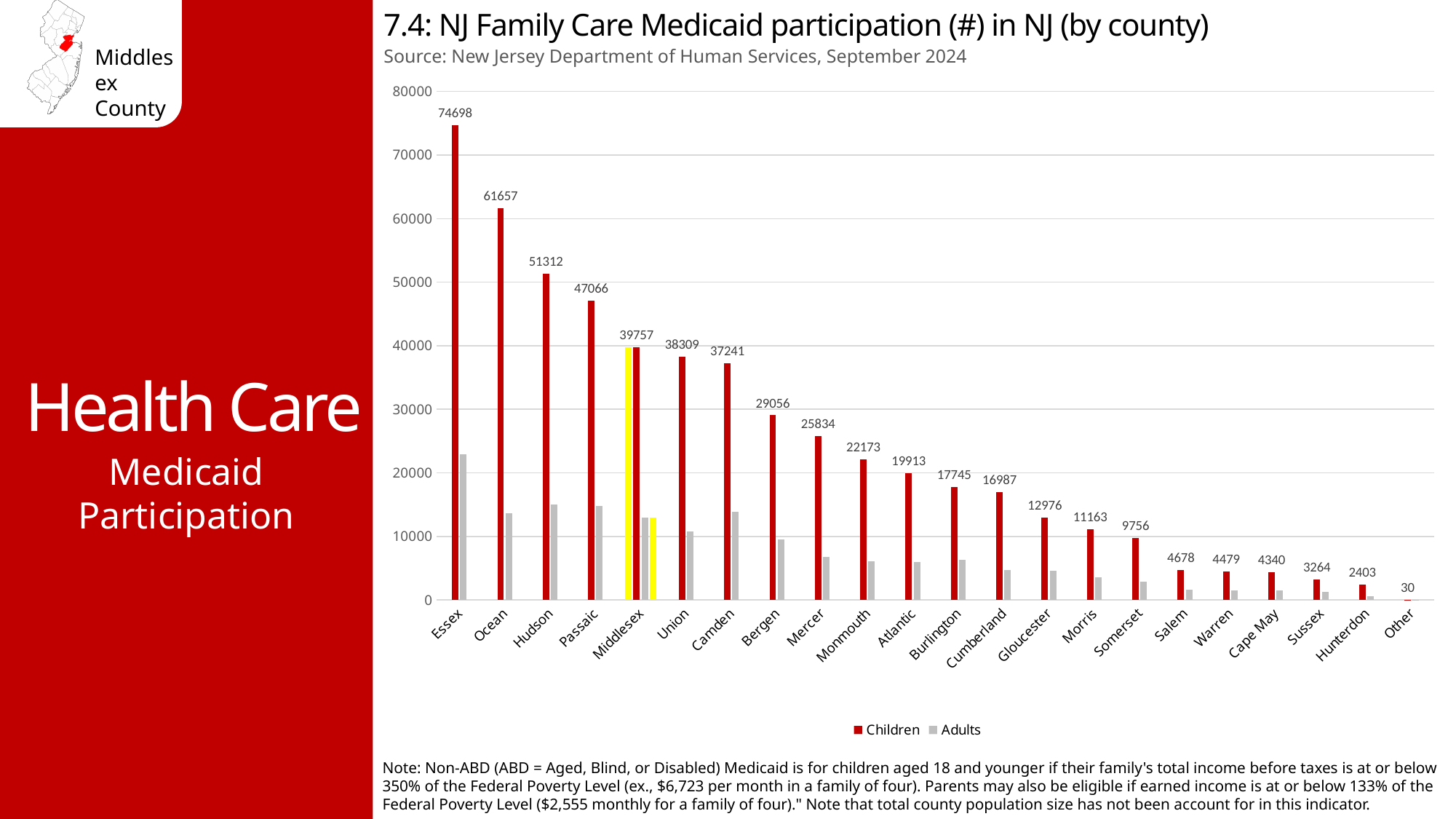
What kind of chart is shown? Bar chart What is the difference between the Children values for Essex and Ocean? 13041 Do the Children values rise or fall from left to right along the x axis? Fall What is the Children value for Middlesex? 39757 How many series does the legend list? 2 Is the Adults value for Essex greater or less than 20000? greater Which county has the highest Children value? Essex Is the Adults value for Hunterdon greater or less than 10000? less How many categories are shown on the x axis? 22 Which category has the lowest Children value? Other Which has a larger Children value, Hudson or Passaic? Hudson What is the Children value for Bergen? 29056